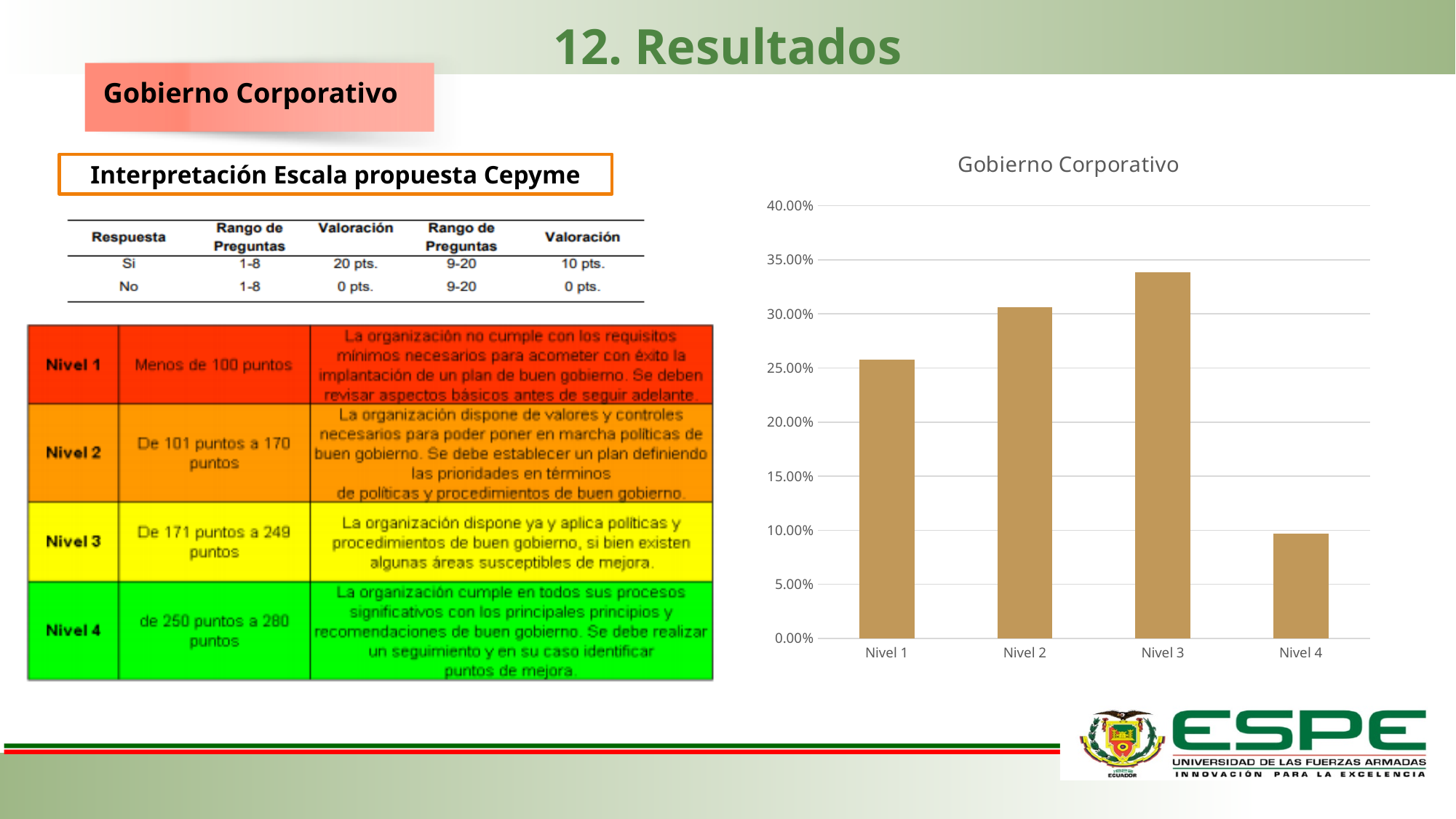
Which category has the highest value in the chart? Nivel 3 Which is larger, the value for Nivel 1 or the value for Nivel 2? Nivel 2 How many categories are plotted in the chart? 4 Is the value for Nivel 1 greater or less than 25.00%? greater Which category has the lowest value in the chart? Nivel 4 What kind of chart is shown on the slide? bar chart Is the value for Nivel 3 greater or less than 35.00%? less Which is larger, the value for Nivel 3 or the value for Nivel 4? Nivel 3 What is the highest value shown on the vertical axis of the chart? 40.00% Is the value for Nivel 2 greater or less than 30.00%? greater What is the title of the chart? Gobierno Corporativo